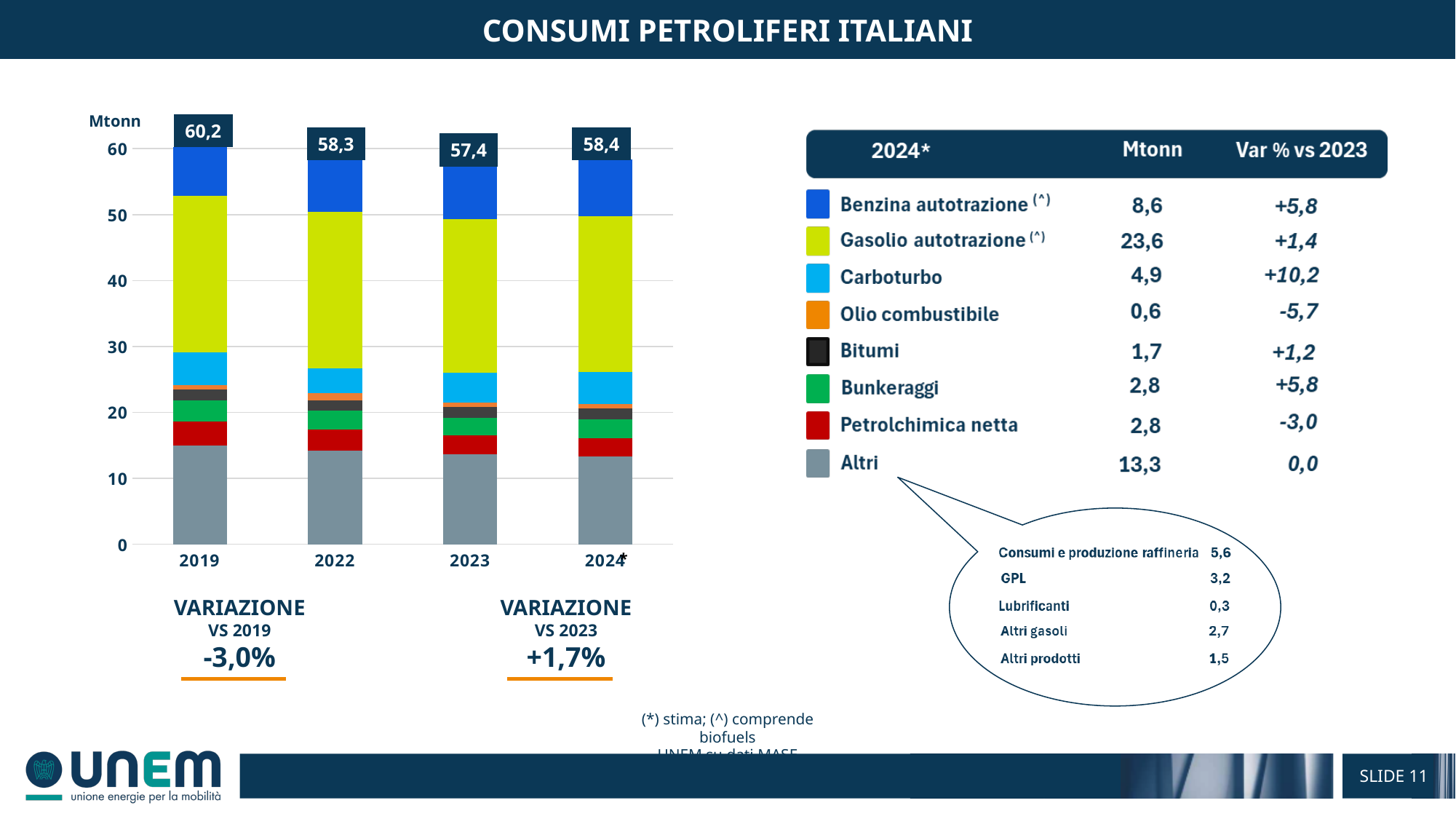
Is the top of the 2019 bar greater or less than 50? greater What is the total value shown on top of the 2024* bar? 58,4 How many product series are listed in the legend table next to the chart? 8 What is the difference between the 2019 total and the 2023 total? 2,8 Which year has the lowest total consumption in the bar chart? 2023 What kind of chart is shown on the slide? Stacked bar chart What is the difference between the 2024* total and the 2023 total? 1,0 What unit is shown on the y axis of the chart? Mtonn How many years (bars) are shown in the bar chart? 4 What is the total value shown on top of the 2019 bar? 60,2 Which is larger, the total for 2022 or the total for 2024*? 2024* Which year has the highest total consumption in the bar chart? 2019